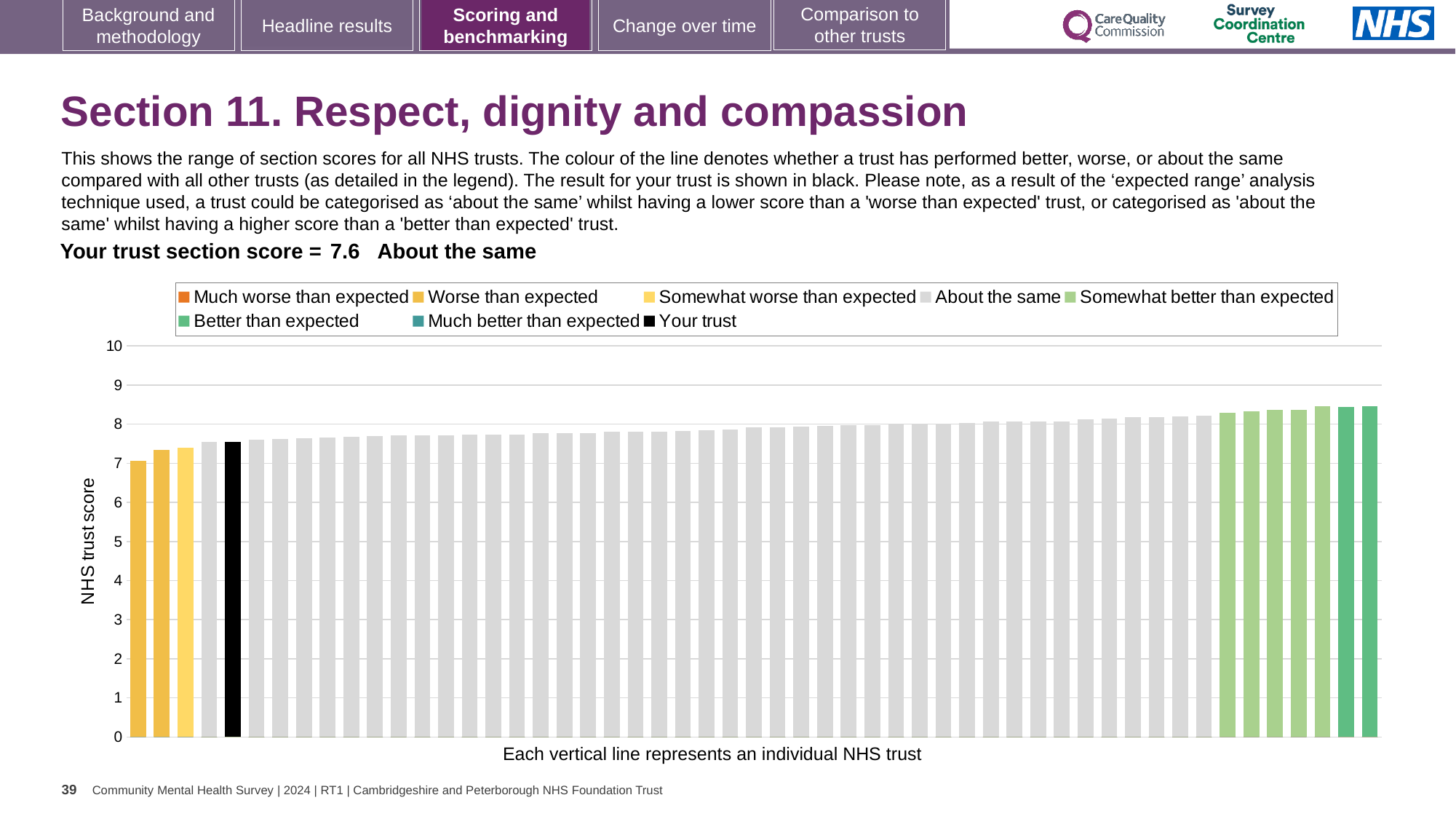
How many bars are coloured as 'Better than expected'? 2 What kind of chart is shown on the slide? bar chart Is the value of the rightmost bar greater or less than 8? greater Is the value for your trust (the black bar) greater or less than 7? greater Which performance category is your trust placed in for this section? About the same Is the value of the leftmost bar greater or less than 8? less Which is higher, the bar for your trust or the leftmost bar? your trust What is the label on the vertical axis of the chart? NHS trust score What is the section score for your trust shown on the slide? 7.6 How many bars are coloured as 'Worse than expected'? 2 How many entries does the chart legend list? 8 Do the bar values rise or fall from left to right along the x axis? rise